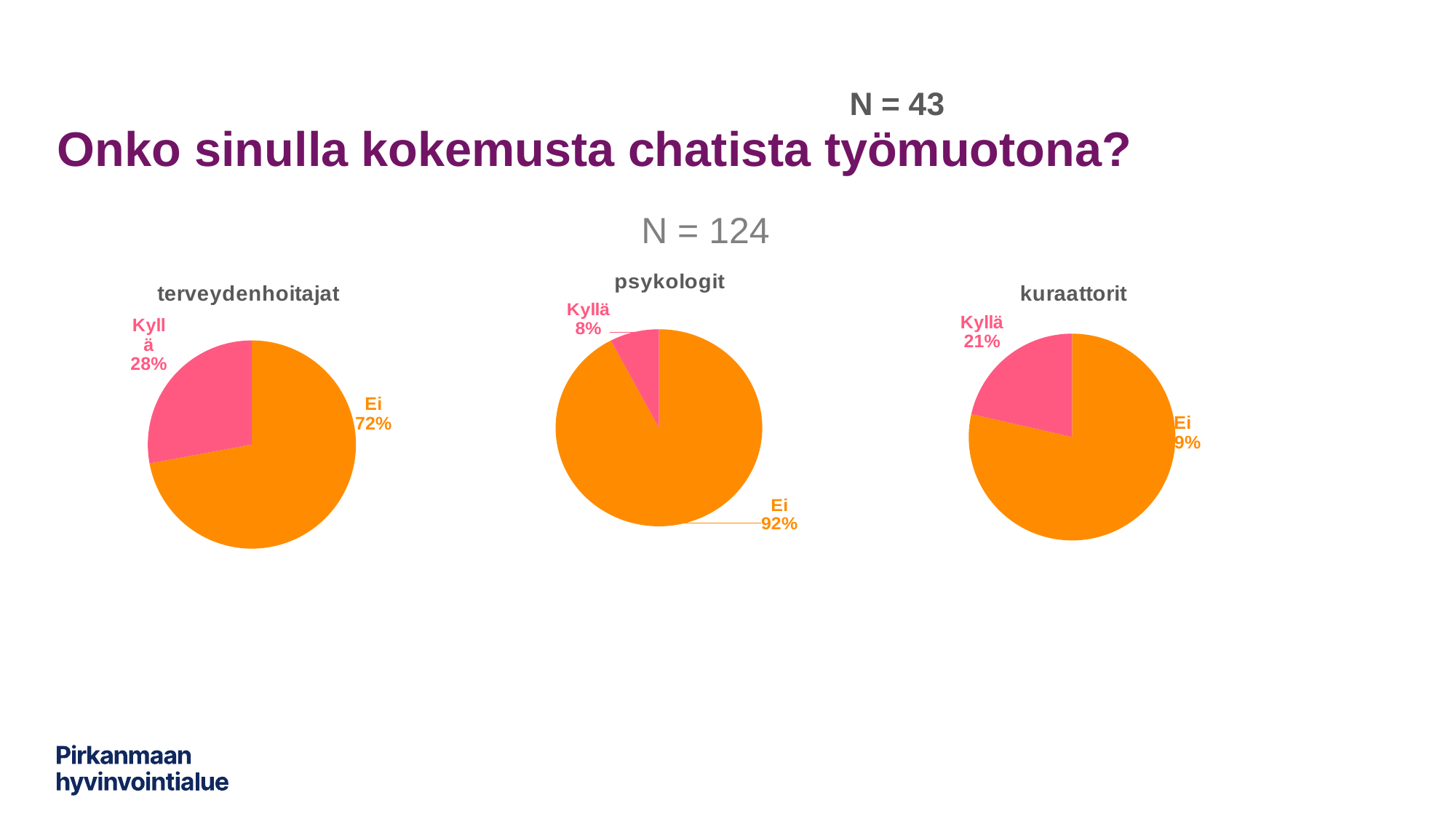
How many pie charts are shown on the slide? 3 What type of chart is used for the psykologit data? Pie chart In the terveydenhoitajat pie chart, which slice is larger, Kyllä or Ei? Ei In the terveydenhoitajat pie chart, what share of respondents answered Kyllä? 28% In the psykologit pie chart, what is the difference between the Ei and Kyllä shares? 84% In the terveydenhoitajat pie chart, what is the difference between the Ei and Kyllä shares? 44% In the kuraattorit pie chart, what share of respondents answered Kyllä? 21% In the terveydenhoitajat pie chart, what share of respondents answered Ei? 72% In the psykologit pie chart, what share of respondents answered Kyllä? 8% In the psykologit pie chart, which slice is the smallest? Kyllä In the psykologit pie chart, what share of respondents answered Ei? 92% Which of the three pie charts has the largest Kyllä share? terveydenhoitajat